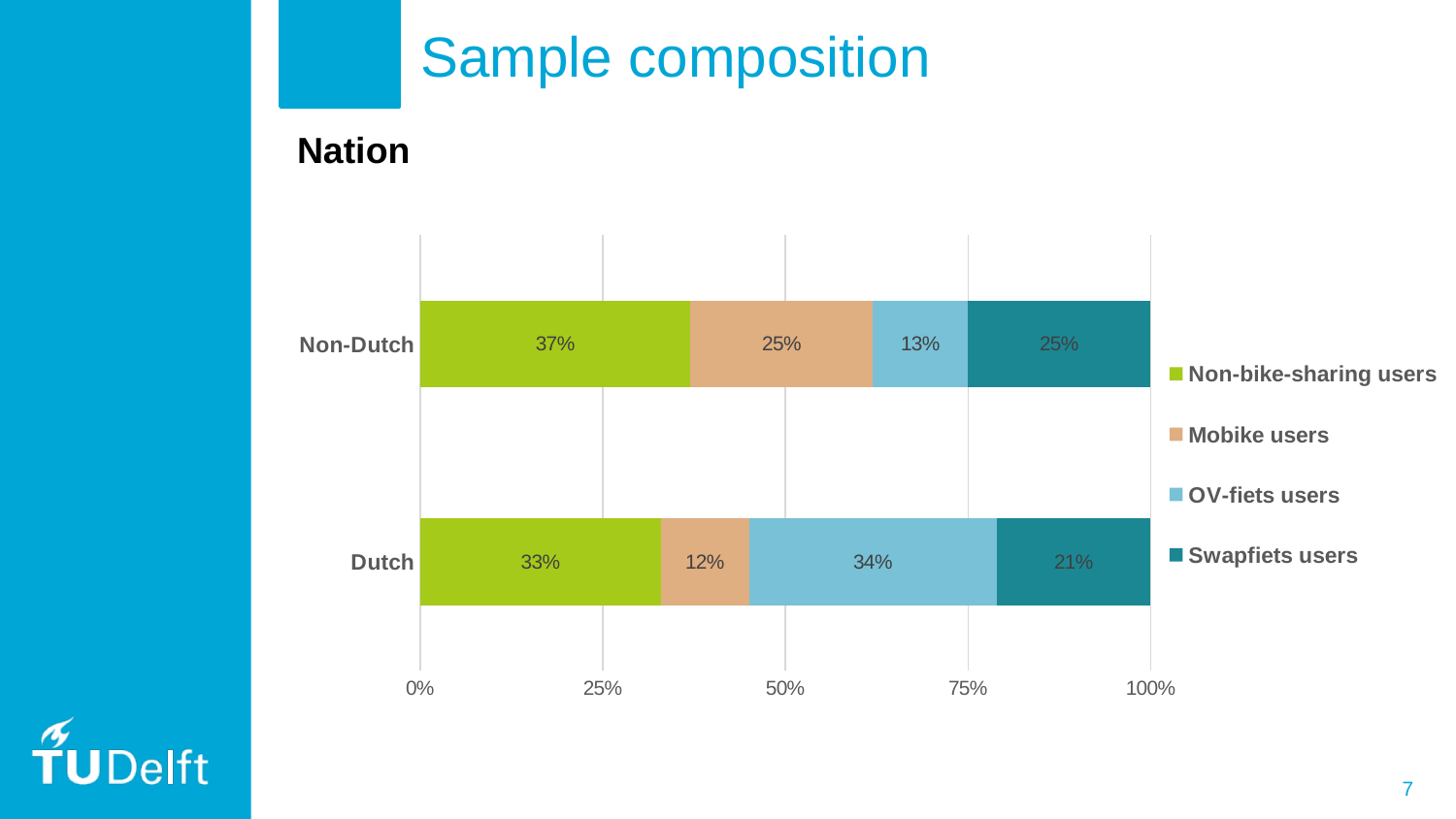
Which user group has the largest share among Dutch respondents? OV-fiets users What is the difference between the OV-fiets users share for Dutch and Non-Dutch respondents? 21% What is the title shown above the chart? Nation How many series does the legend list? 4 Which user group has the smallest share among Non-Dutch respondents? OV-fiets users How many categories are shown on the vertical axis? 2 What percentage of Dutch respondents are OV-fiets users? 34% What percentage of Dutch respondents are Mobike users? 12% What percentage of Non-Dutch respondents are Non-bike-sharing users? 37% Which group has a larger share of Mobike users, Dutch or Non-Dutch? Non-Dutch What kind of chart is shown on the slide? Stacked bar chart What percentage of Non-Dutch respondents are Swapfiets users? 25%